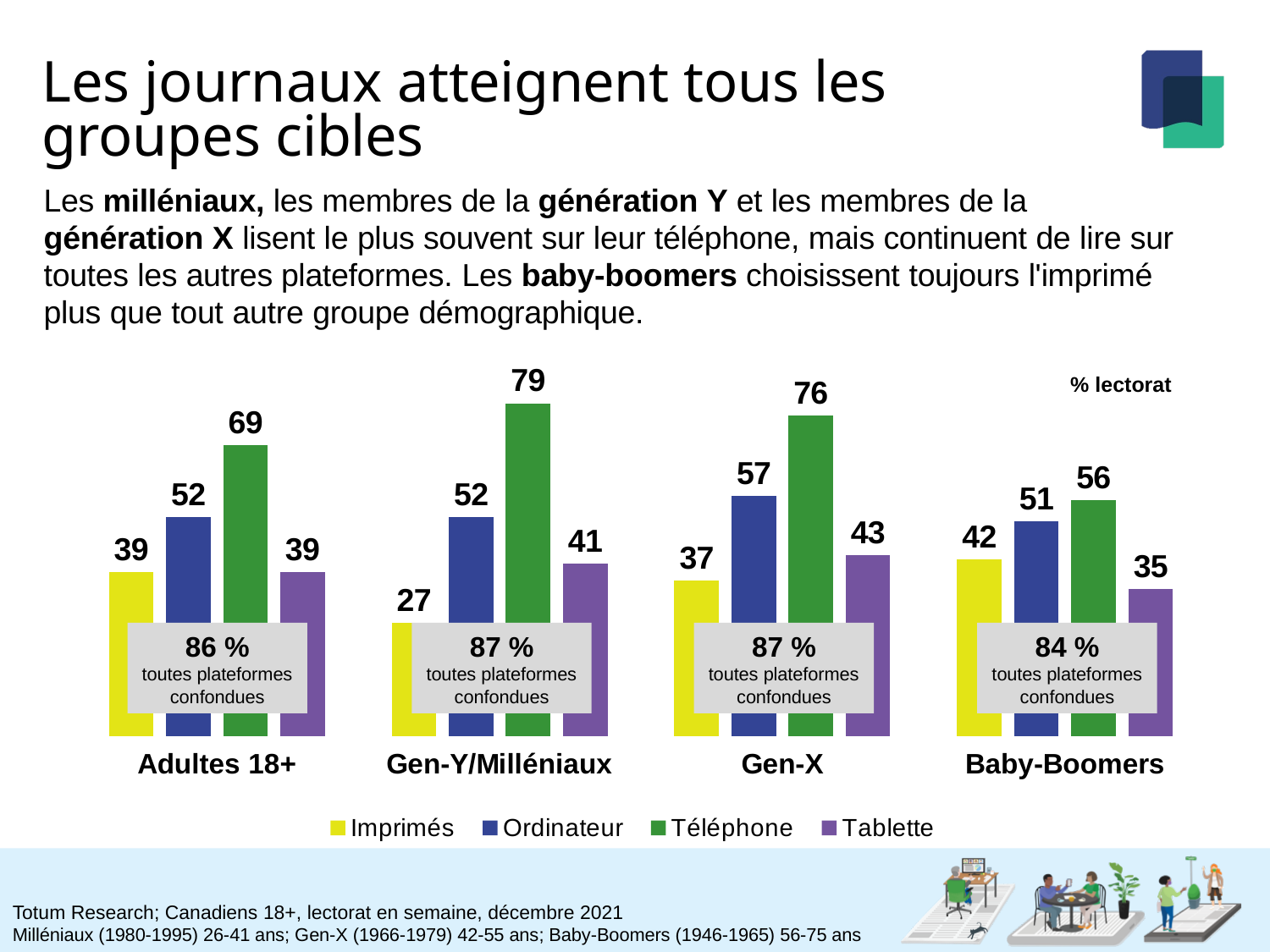
What is the Imprimés value for Baby-Boomers? 42 What is the Tablette value for Gen-X? 43 What is the 'toutes plateformes confondues' percentage shown for Baby-Boomers? 84 % Which group has the lowest Imprimés value? Gen-Y/Milléniaux Which is larger for Baby-Boomers: the Ordinateur value or the Tablette value? Ordinateur Which group has the highest Téléphone value? Gen-Y/Milléniaux Which colour represents Téléphone in the legend? Green What is the Téléphone value for Gen-Y/Milléniaux? 79 How many groups are shown on the x axis? 4 What kind of chart is shown? Bar chart What is the difference between the Téléphone and Imprimés values for Gen-X? 39 How many series does the legend list? 4